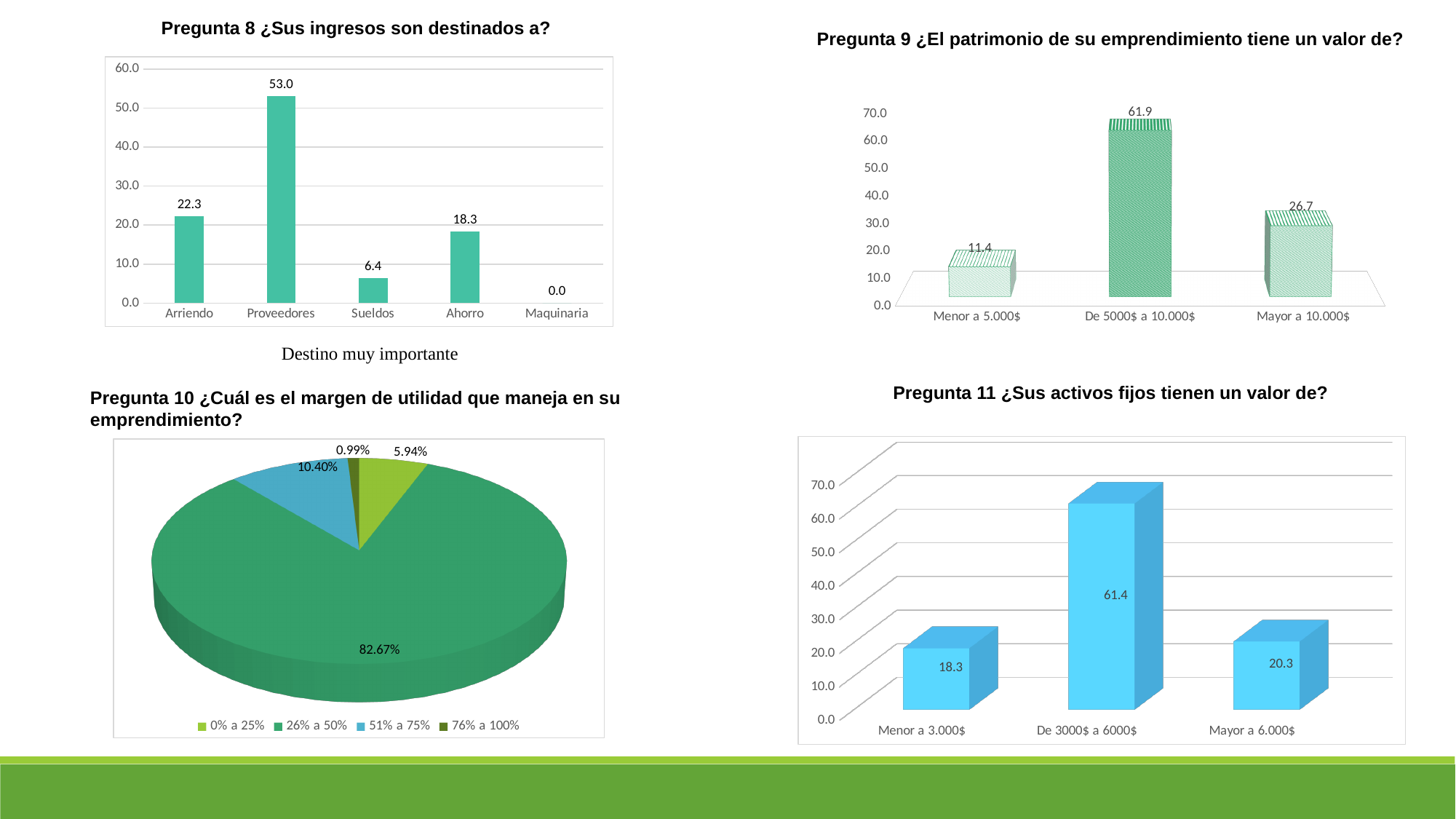
In the 'Pregunta 9 ¿El patrimonio de su emprendimiento tiene un valor de?' chart, which category has the highest value? De 5000$ a 10.000$ In the 'Pregunta 8 ¿Sus ingresos son destinados a?' chart, what is the value for Proveedores? 53.0 In the 'Pregunta 11 ¿Sus activos fijos tienen un valor de?' chart, what is the value for 'De 3000$ a 6000$'? 61.4 In the 'Pregunta 9 ¿El patrimonio de su emprendimiento tiene un valor de?' chart, what is the difference between 'Mayor a 10.000$' and 'Menor a 5.000$'? 15.3 In the 'Pregunta 11 ¿Sus activos fijos tienen un valor de?' chart, which is larger: 'Menor a 3.000$' or 'Mayor a 6.000$'? Mayor a 6.000$ How many entries does the legend of the 'Pregunta 10' pie chart list? 4 In the 'Pregunta 10' pie chart, what share does the '26% a 50%' slice have? 82.67% In the 'Pregunta 9 ¿El patrimonio de su emprendimiento tiene un valor de?' chart, what is the value for 'De 5000$ a 10.000$'? 61.9 How many categories are shown in the 'Pregunta 8 ¿Sus ingresos son destinados a?' chart? 5 In the 'Pregunta 8 ¿Sus ingresos son destinados a?' chart, which category has the lowest value? Maquinaria What kind of chart is used for 'Pregunta 10 ¿Cuál es el margen de utilidad que maneja en su emprendimiento?'? Pie chart In the 'Pregunta 8 ¿Sus ingresos son destinados a?' chart, what is the difference between the values for Arriendo and Ahorro? 4.0